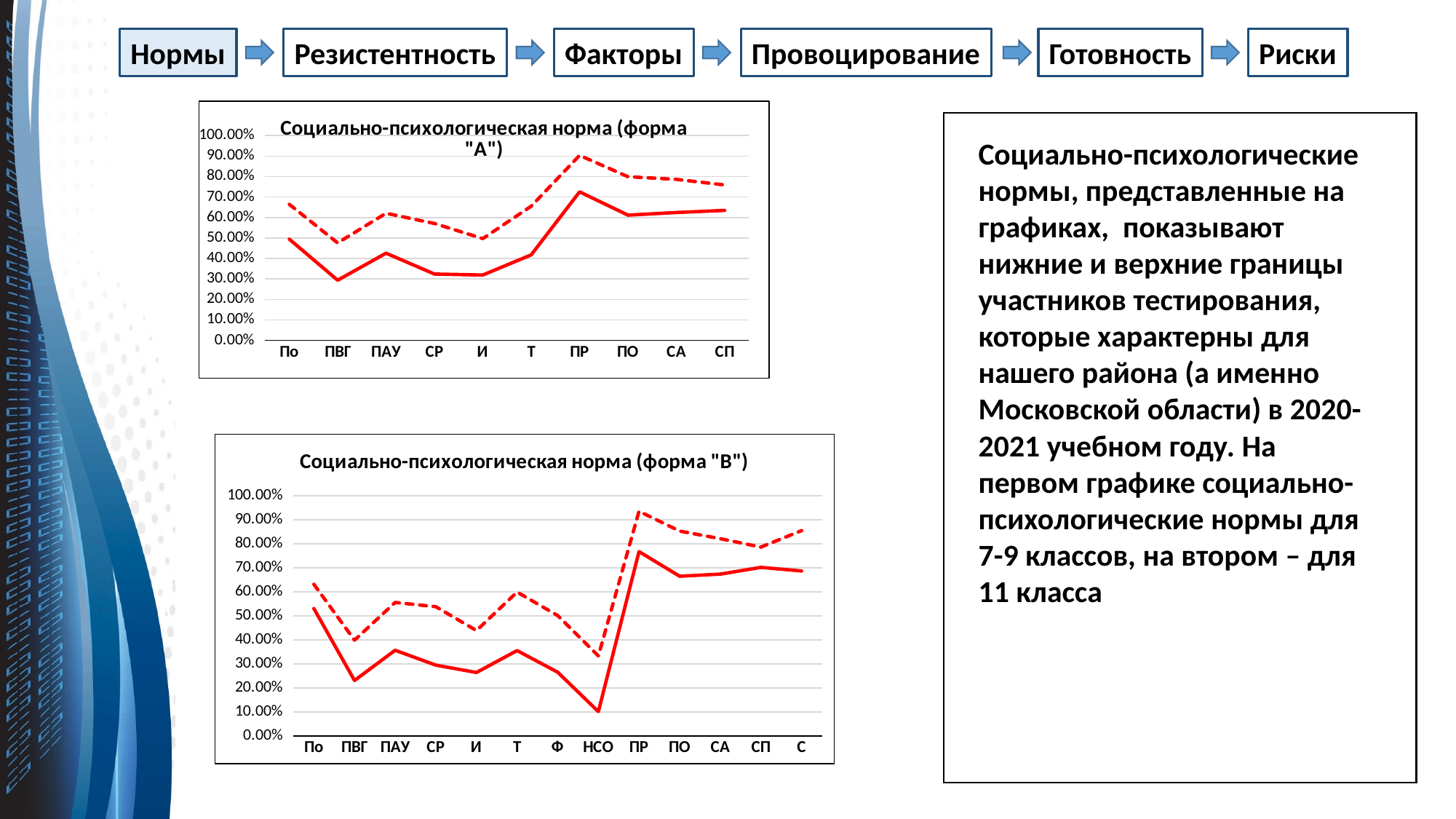
What type of chart is "Социально-психологическая норма (форма "А")"? line chart In the chart "Социально-психологическая норма (форма "В")", is the solid-line value for НСО greater or less than 20.00%? less How many categories are shown on the x axis of the chart "Социально-психологическая норма (форма "В")"? 13 In the chart "Социально-психологическая норма (форма "В")", which category has the highest value on the dashed line? ПР In the chart "Социально-психологическая норма (форма "А")", is the dashed-line value for ПР greater or less than 80.00%? greater How many categories are shown on the x axis of the chart "Социально-психологическая норма (форма "А")"? 10 How many lines are plotted in the chart "Социально-психологическая норма (форма "А")"? 2 In the chart "Социально-психологическая норма (форма "В")", is the solid-line value for ПВГ greater or less than 30.00%? less In the chart "Социально-психологическая норма (форма "В")", which has the larger solid-line value, По or ПВГ? По In the chart "Социально-психологическая норма (форма "В")", which category has the lowest value on the solid line? НСО In the chart "Социально-психологическая норма (форма "А")", which category has the highest value on the solid line? ПР